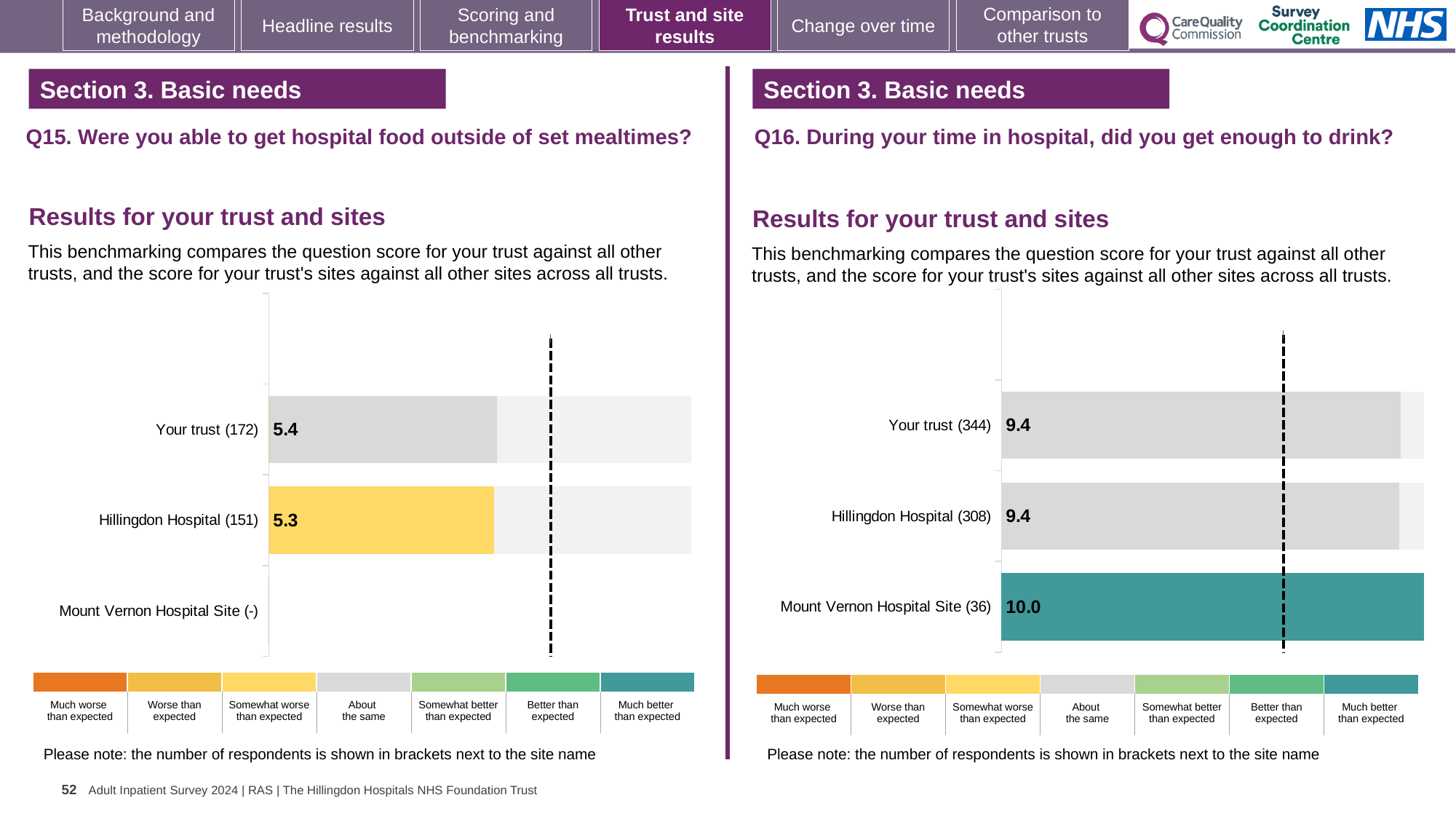
On the Q16 chart (right), which site or trust has the highest score? Mount Vernon Hospital Site On the Q16 chart (right), how many respondents are shown for Mount Vernon Hospital Site? 36 What kind of chart is used on the Q15 chart (left)? Bar chart On the Q15 chart (left), which benchmark category does the colour of the Hillingdon Hospital bar correspond to? Somewhat worse than expected On the Q15 chart (left), how many respondents are shown for Your trust? 172 On the Q16 chart (right), what is the difference between the Mount Vernon Hospital Site score and the Your trust score? 0.6 On the Q16 chart (right), what is the score for Hillingdon Hospital? 9.4 On the Q15 chart (left), what is the difference between the Your trust score and the Hillingdon Hospital score? 0.1 On the Q16 chart (right), what is the score for Mount Vernon Hospital Site? 10.0 On the Q15 chart (left), what is the score for Hillingdon Hospital? 5.3 On the Q15 chart (left), what is the score for Your trust? 5.4 On the Q16 chart (right), which benchmark category does the colour of the Mount Vernon Hospital Site bar correspond to? Much better than expected